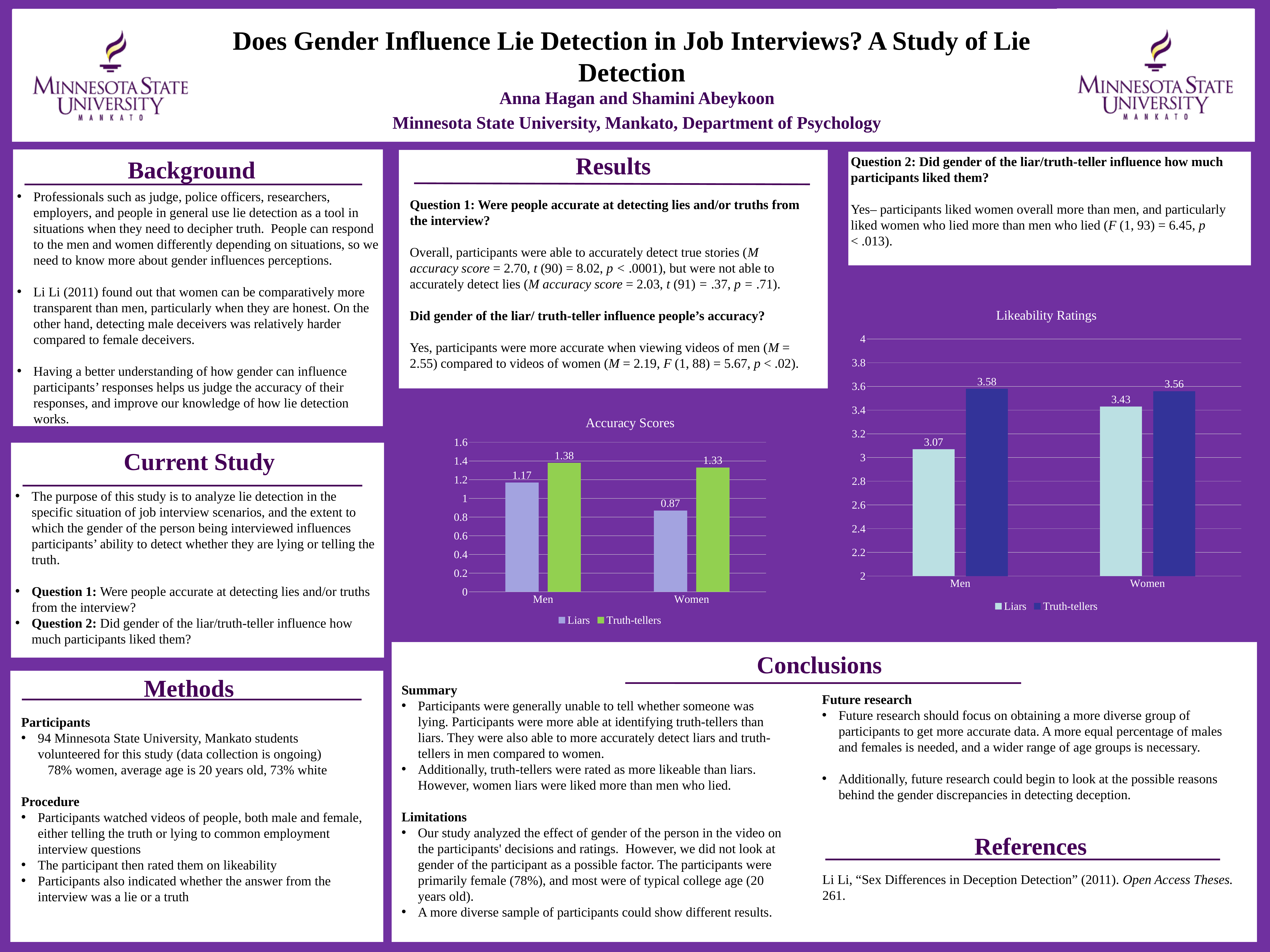
In the Likeability Ratings chart, what is the difference between the Liars values for Women and Men? 0.36 In the Accuracy Scores chart, is the Liars value for Women greater or less than 1? less What type of chart is the Likeability Ratings chart? Bar chart In the Likeability Ratings chart, what is the value for Truth-tellers in the Women category? 3.56 In the Accuracy Scores chart, which category has the lowest Liars value? Women In the Accuracy Scores chart, what is the value for Liars in the Men category? 1.17 In the Accuracy Scores chart, what is the value for Truth-tellers in the Women category? 1.33 In the Accuracy Scores chart, what is the difference between the Truth-tellers and Liars values for Men? 0.21 In the Likeability Ratings chart, what is the value for Liars in the Men category? 3.07 In the Likeability Ratings chart, which is larger: the Liars value for Women or the Liars value for Men? Women In the Accuracy Scores chart, how many series does the legend list? 2 In the Likeability Ratings chart, which bar is the highest? Truth-tellers for Men (3.58)